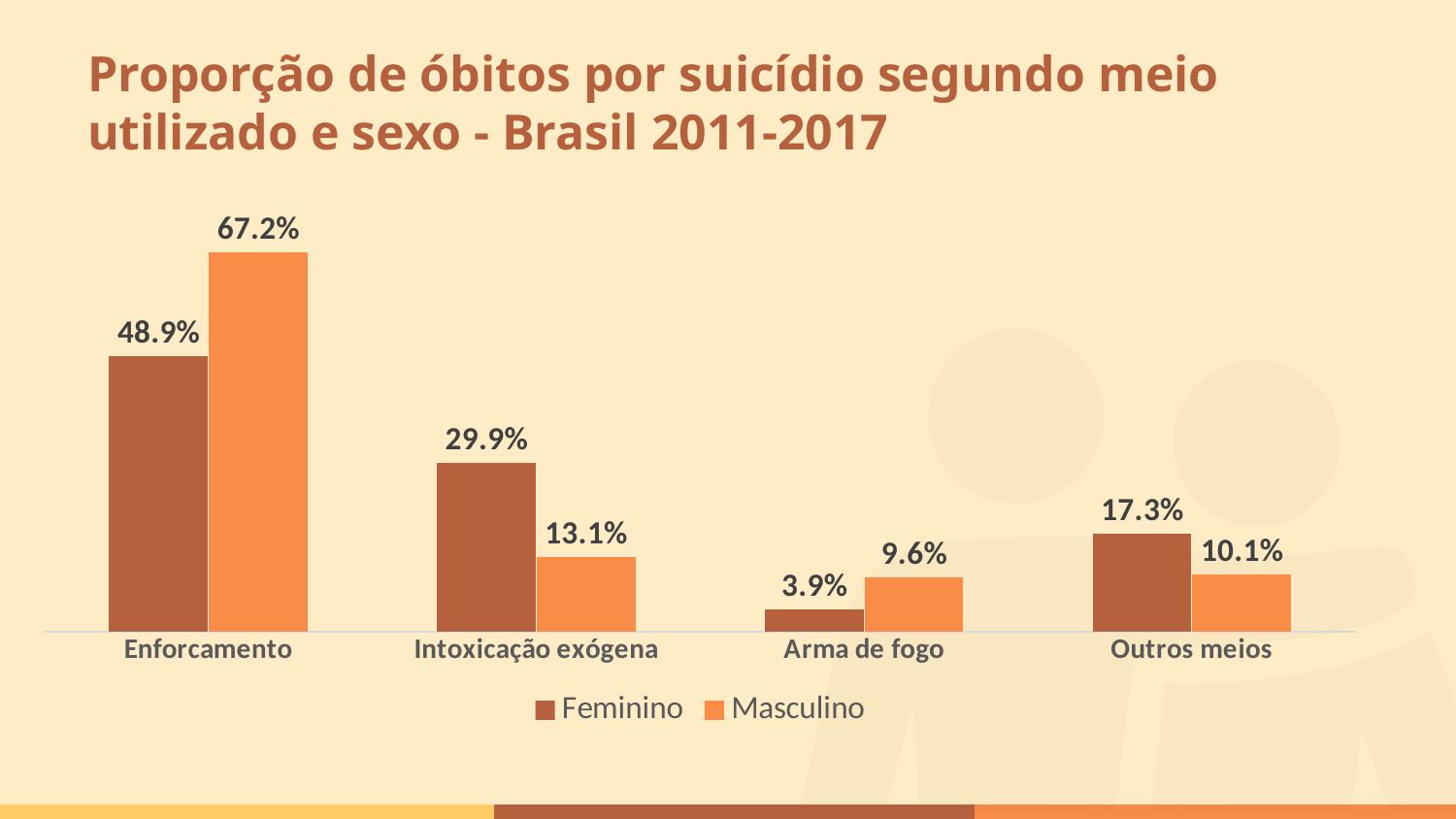
What is the difference between the Masculino and Feminino values for Enforcamento? 18.3% What colour represents the Masculino series? Orange How many series does the legend list? 2 Which category has the highest Masculino value? Enforcamento What kind of chart is shown on the slide? Bar chart What is the Feminino value for Enforcamento? 48.9% What is the Feminino value for Arma de fogo? 3.9% Which is larger for Intoxicação exógena, the Feminino or the Masculino value? Feminino What is the Masculino value for Intoxicação exógena? 13.1% What is the Masculino value for Outros meios? 10.1% Which category has the lowest Feminino value? Arma de fogo How many categories are shown on the x axis? 4